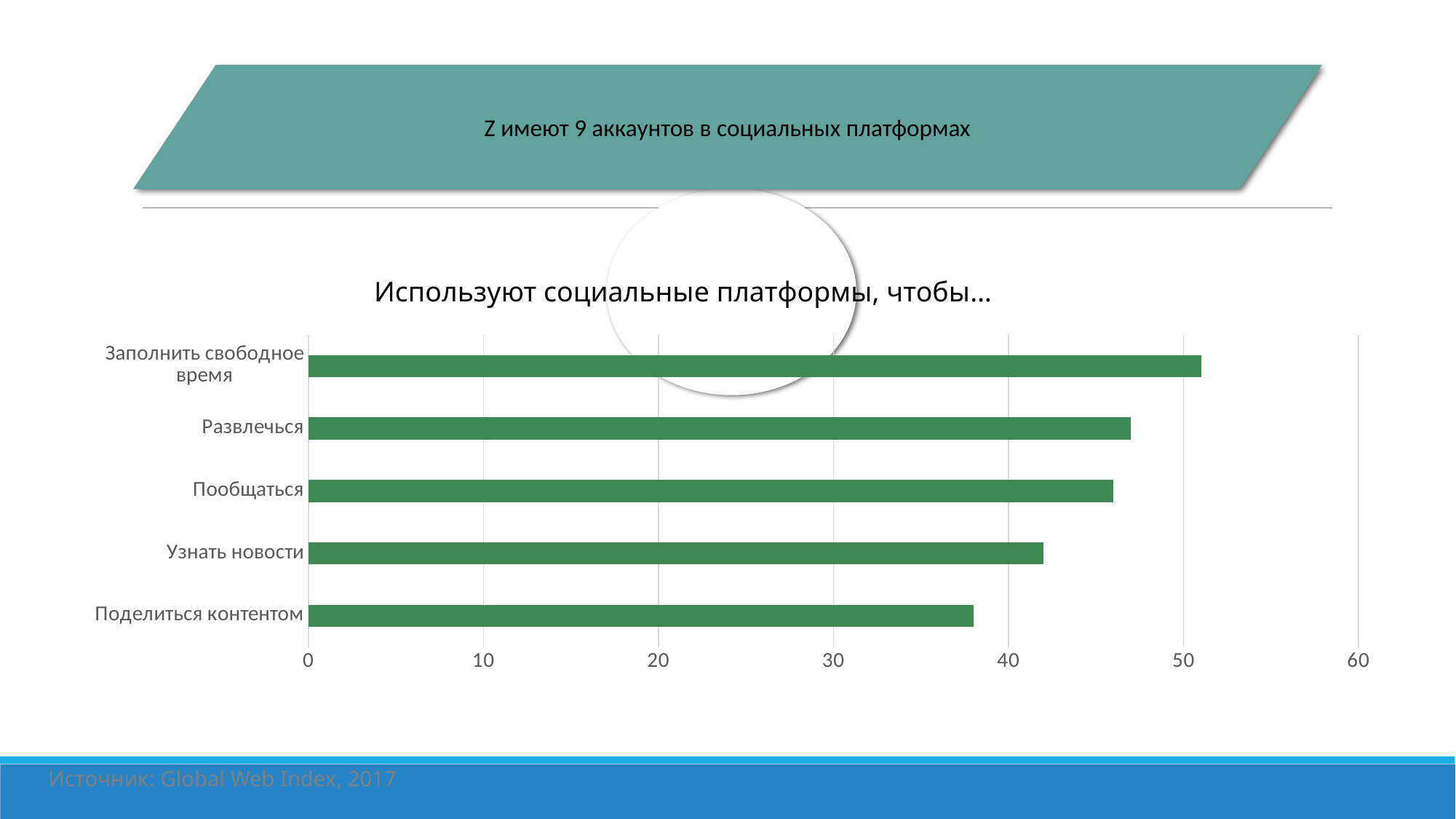
Do the bar lengths increase or decrease from the top category to the bottom category? decrease Which is larger, the value for Поделиться контентом or the value for Пообщаться? Пообщаться Is the value for Развлечься greater or less than 50? less Which is larger, the value for Развлечься or the value for Узнать новости? Развлечься Is the value for Пообщаться greater or less than 40? greater What is the title of the chart? Используют социальные платформы, чтобы… Is the value for Поделиться контентом greater or less than 40? less How many categories are shown in the chart? 5 Which category has the shortest bar? Поделиться контентом Which category has the longest bar? Заполнить свободное время What kind of chart is shown on the slide? bar chart